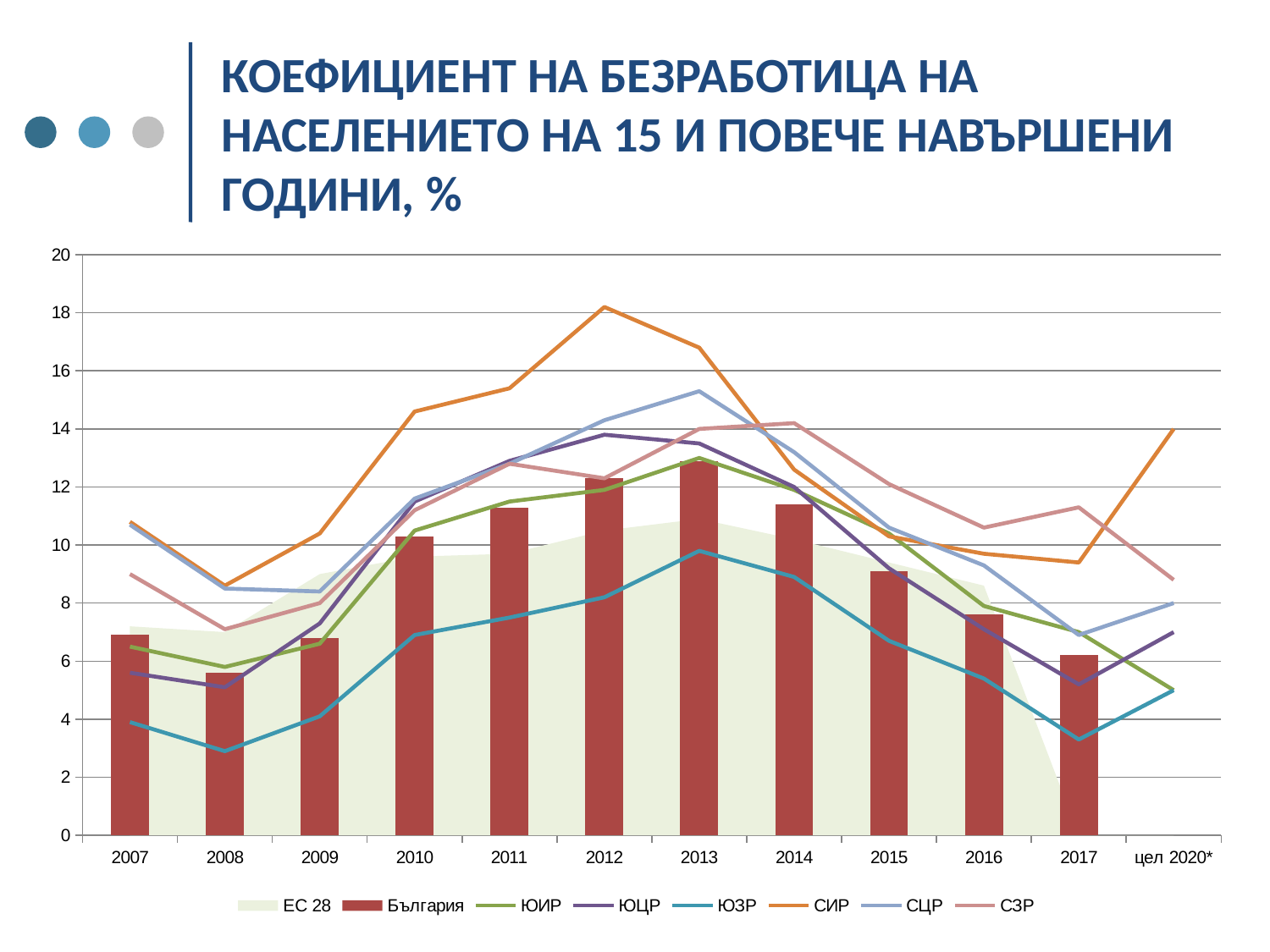
Which is larger for България: the value in 2013 or the value in 2017? 2013 In which year is the България bar lowest? 2008 Is the value for СИР in 2012 greater or less than 16? greater Which series has the lowest value in 2008? ЮЗР Do the България bars rise or fall from 2013 to 2017? fall How many categories are shown on the x axis? 12 How many series does the legend list? 8 In which year is the България bar highest? 2013 Is the value for България in 2013 greater or less than 12? greater What kind of chart is used to show the България series? bar chart Which series reaches the highest value anywhere on the chart? СИР Is the value for ЮЗР in 2008 greater or less than 4? less